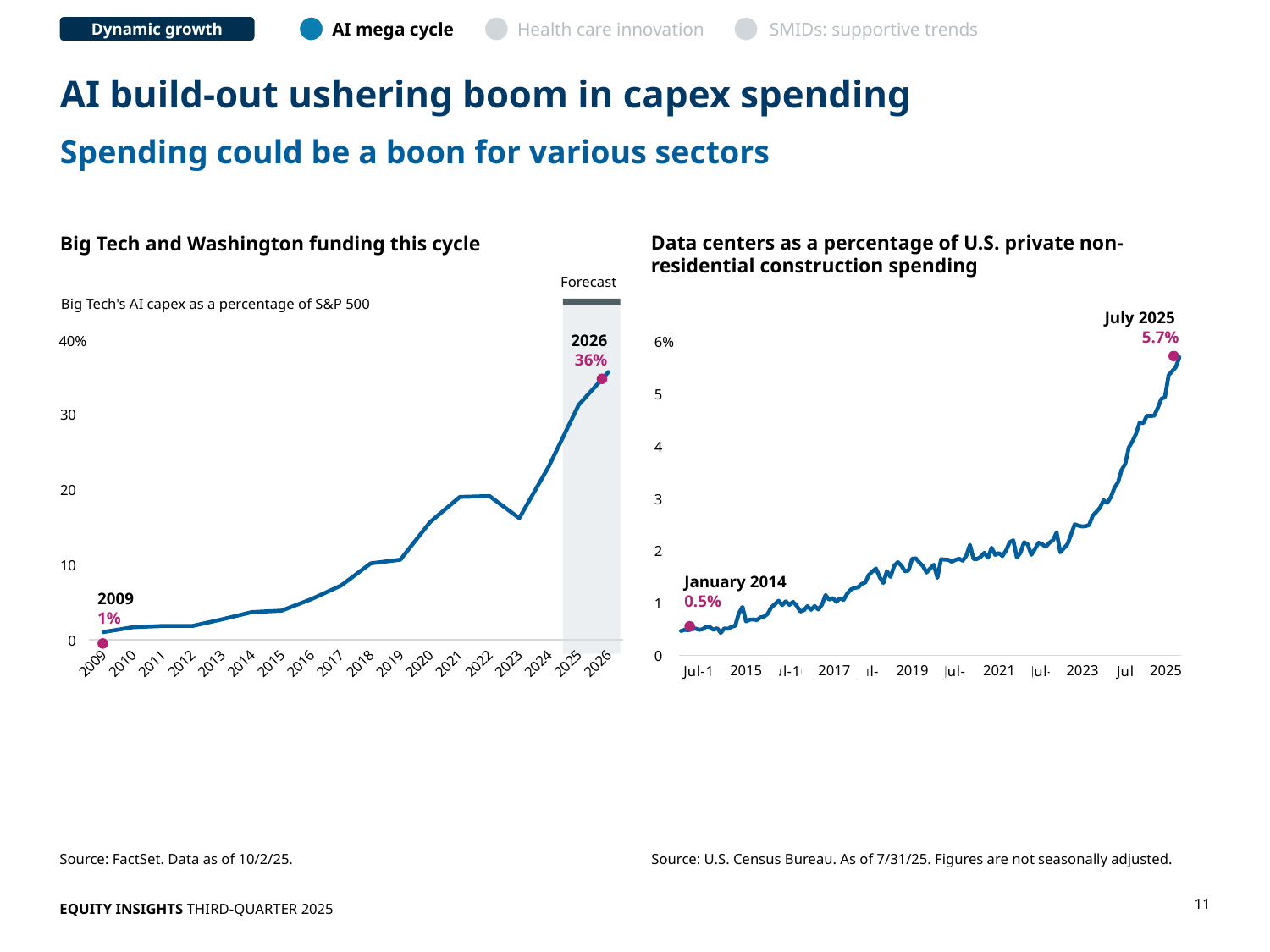
In the 'Data centers as a percentage of U.S. private non-residential construction spending' chart, what value is labeled for January 2014? 0.5% What kind of chart is the 'Big Tech and Washington funding this cycle' chart? Line chart In the 'Big Tech and Washington funding this cycle' chart, what value is labeled for 2026? 36% In the 'Big Tech and Washington funding this cycle' chart, which years are covered by the shaded 'Forecast' region? 2025 and 2026 In the 'Data centers as a percentage of U.S. private non-residential construction spending' chart, what is the difference between the July 2025 value and the January 2014 value? 5.2 percentage points In the 'Big Tech and Washington funding this cycle' chart, what is the difference between the labeled 2026 value and the labeled 2009 value? 35 percentage points In the 'Data centers as a percentage of U.S. private non-residential construction spending' chart, do values generally rise or fall from 2014 to 2025? Rise In the 'Big Tech and Washington funding this cycle' chart, which year has the highest value? 2026 In the 'Data centers as a percentage of U.S. private non-residential construction spending' chart, what value is labeled for July 2025? 5.7% In the 'Big Tech and Washington funding this cycle' chart, is the value for 2021 greater or less than 10? greater In the 'Big Tech and Washington funding this cycle' chart, is the value for 2016 greater or less than 10? less In the 'Big Tech and Washington funding this cycle' chart, what value is labeled for 2009? 1%